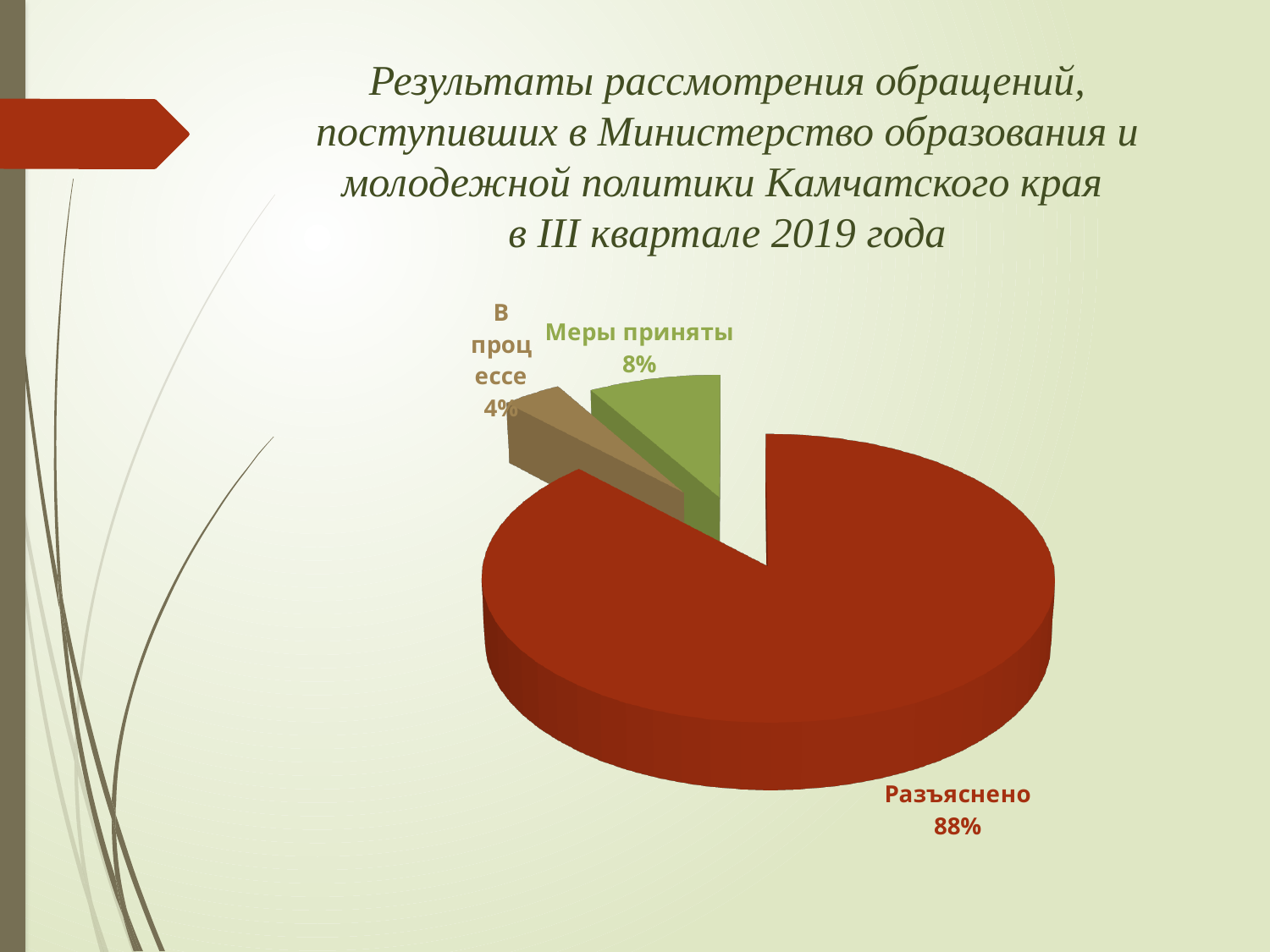
What share of the pie does the "Разъяснено" slice represent? 88% Which slice is larger, "Меры приняты" or "В процессе"? Меры приняты What share of the pie does the "В процессе" slice represent? 4% Which category has the largest slice of the pie? Разъяснено What colour is the "Меры приняты" slice? Green What is the difference in percentage points between the "Разъяснено" and "Меры приняты" slices? 80 What is the difference in percentage points between the "Меры приняты" and "В процессе" slices? 4 What kind of chart is shown on the slide? Pie chart What share of the pie does the "Меры приняты" slice represent? 8% Which category has the smallest slice of the pie? В процессе How many slices does the pie chart have? 3 What colour is the "Разъяснено" slice? Red